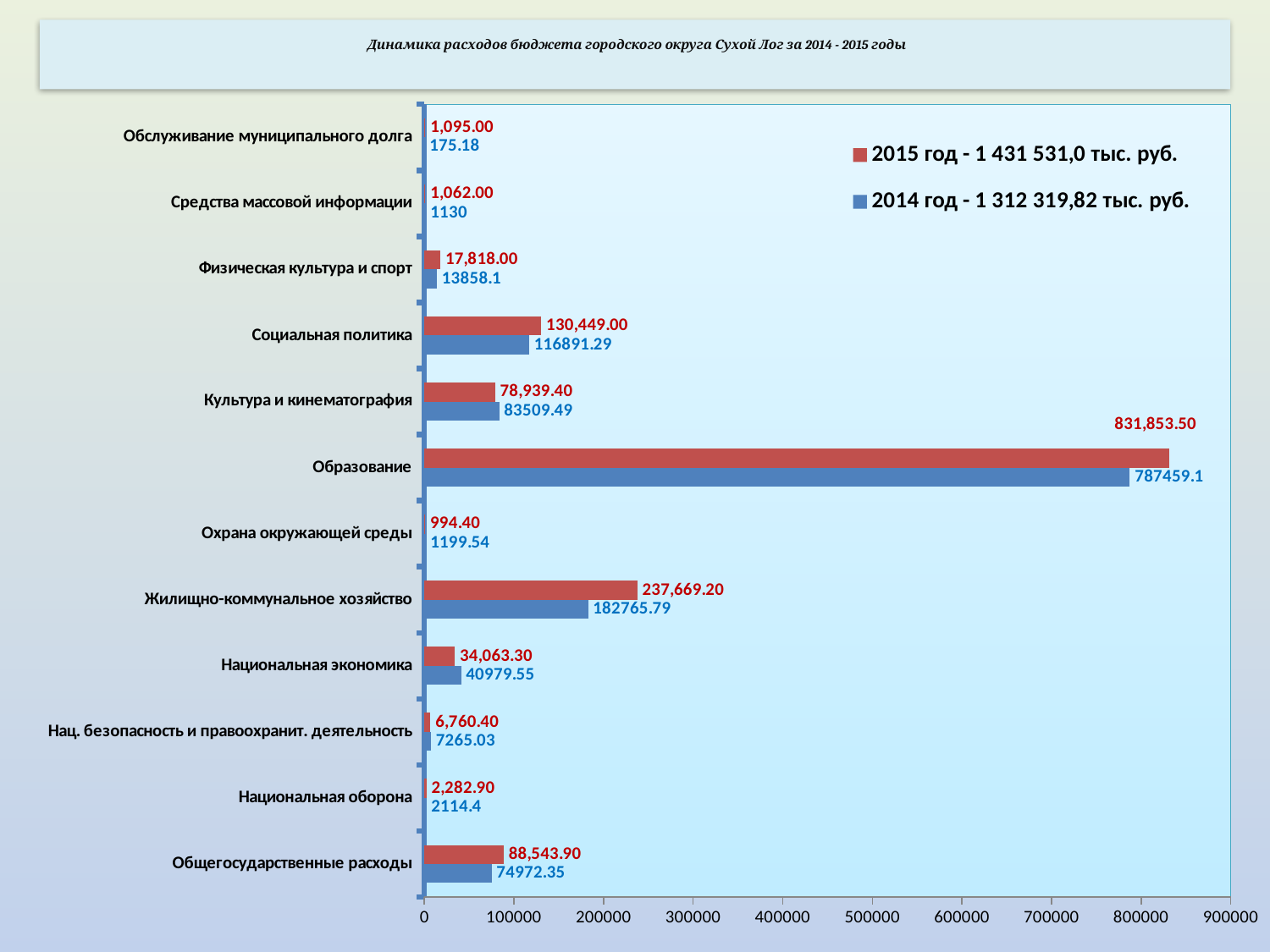
Which is larger for Национальная экономика: the 2015 value or the 2014 value? 2014 value How many series does the legend list? 2 Which category has the lowest 2014 value? Обслуживание муниципального долга By how much does the 2015 value for Образование exceed the 2014 value? 44,394.4 What is the 2015 value for Образование? 831,853.50 What is the 2015 value for Социальная политика? 130,449.00 What is the 2014 value for Жилищно-коммунальное хозяйство? 182765.79 How many expenditure categories are shown on the chart? 12 What type of chart is shown on the slide? Bar chart What is the 2014 value for Обслуживание муниципального долга? 175.18 Which category has the highest 2015 value? Образование According to the legend, what is the total for 2015 год? 1 431 531,0 тыс. руб.